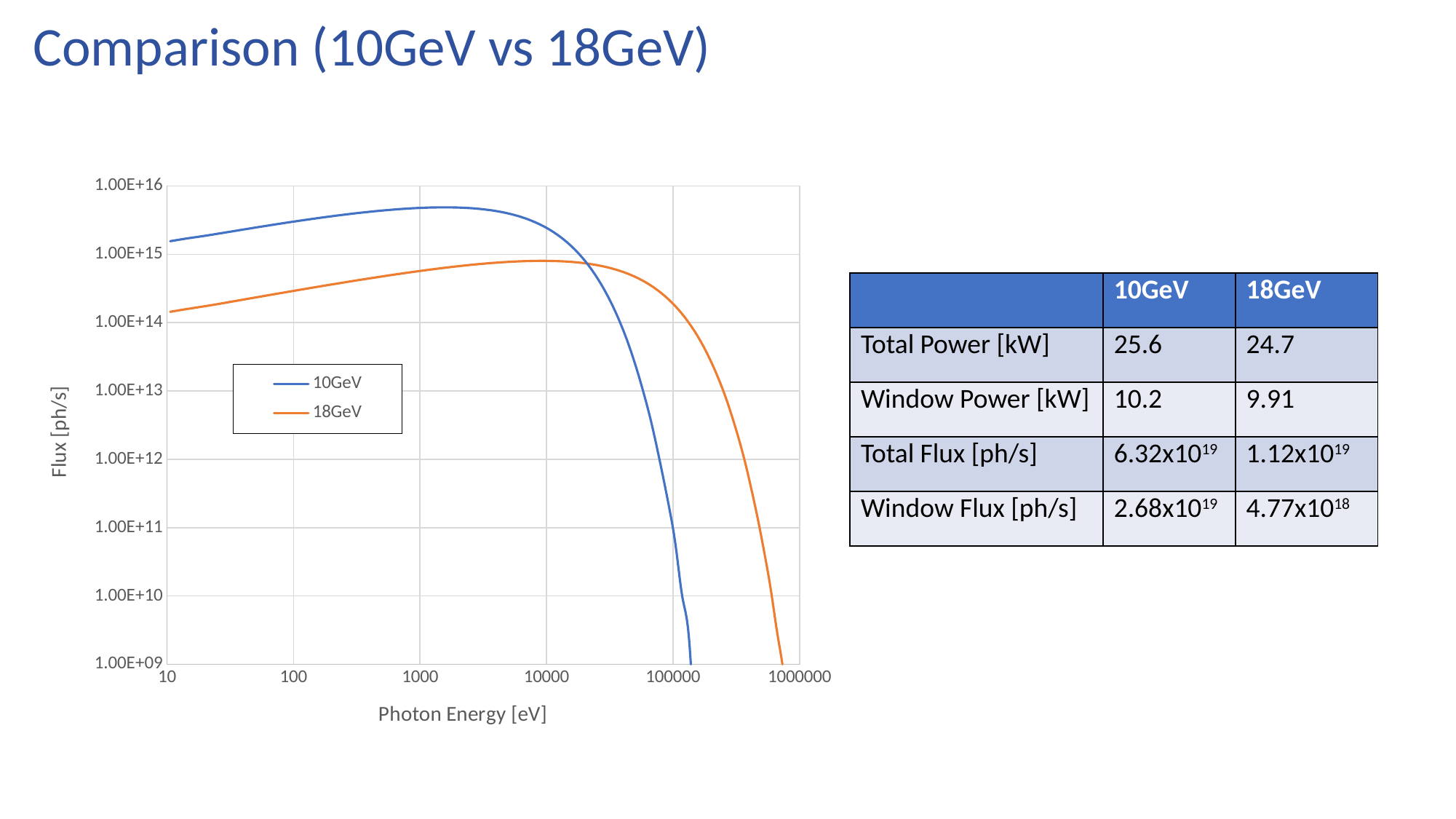
How many series does the chart's legend list? 2 Is the 10GeV flux at a photon energy of 10000 eV greater or less than 1.00E+15? greater At a photon energy of 100000 eV, which series has the higher flux, 10GeV or 18GeV? 18GeV Is the 10GeV flux at a photon energy of 10 eV greater or less than 1.00E+15? greater What are the two series named in the chart's legend? 10GeV and 18GeV Is the 18GeV flux at a photon energy of 1000 eV greater or less than 1.00E+15? less What is the label of the chart's x axis? Photon Energy [eV] At a photon energy of 1000 eV, which series has the higher flux, 10GeV or 18GeV? 10GeV What kind of chart is shown on the slide? line chart Which series reaches the higher peak flux? 10GeV Does the 10GeV flux rise or fall as photon energy increases from 10000 eV to 100000 eV? fall